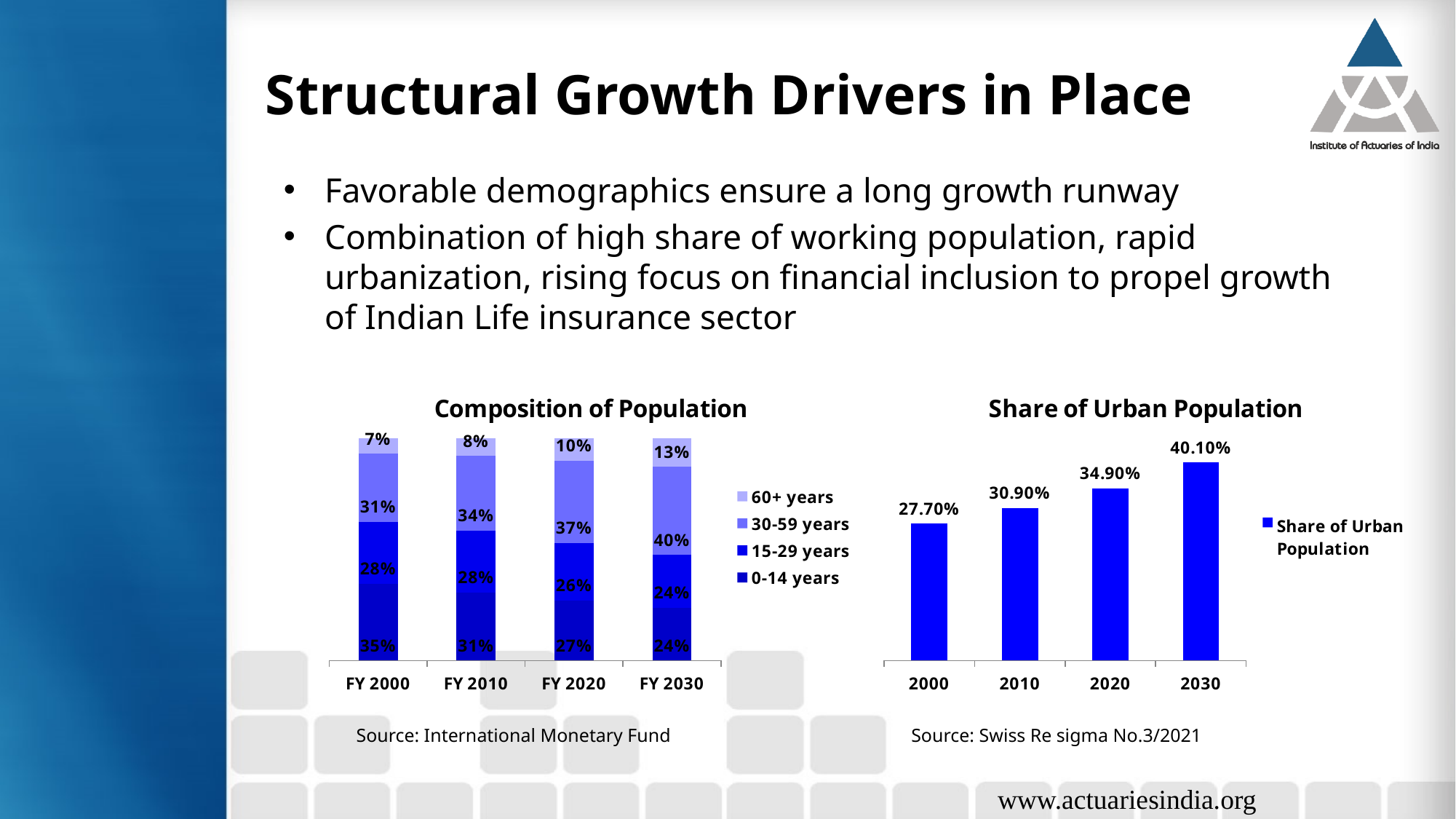
In the Composition of Population chart, which fiscal year has the highest share for the 60+ years group? FY 2030 In the Composition of Population chart, what is the share of the 0-14 years group in FY 2000? 35% What kind of chart is the Share of Urban Population chart? bar chart In the Share of Urban Population chart, do the values rise or fall from 2000 to 2030? rise In the Composition of Population chart, what is the share of the 60+ years group in FY 2020? 10% In the Composition of Population chart, is the 0-14 years share larger in FY 2000 or FY 2030? FY 2000 How many series does the legend of the Composition of Population chart list? 4 In the Share of Urban Population chart, what is the difference between the 2020 and 2010 values? 4.00% In the Share of Urban Population chart, which year has the lowest value? 2000 In the Composition of Population chart, what is the share of the 30-59 years group in FY 2030? 40% In the Share of Urban Population chart, what is the value for 2000? 27.70% In the Share of Urban Population chart, what is the value for 2030? 40.10%